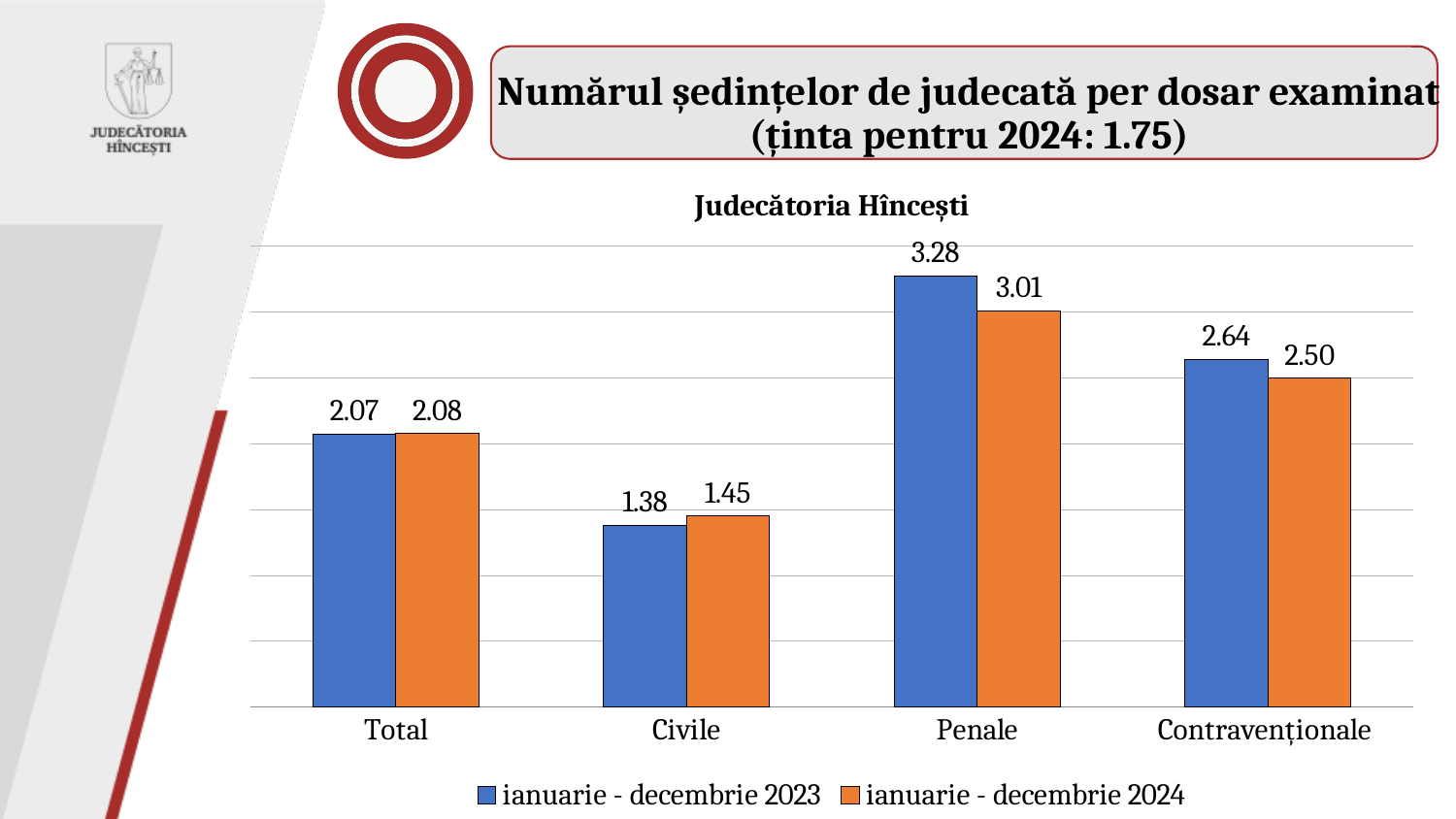
Which category has the lowest value in the ianuarie - decembrie 2023 series? Civile What is the title of the chart? Judecătoria Hîncești What is the value for Penale in the ianuarie - decembrie 2023 series? 3.28 Which category has the highest value in the ianuarie - decembrie 2024 series? Penale How many series does the legend list? 2 What kind of chart is shown on the slide? Bar chart What is the difference between the 2023 and 2024 values for Penale? 0.27 What is the value for Civile in the ianuarie - decembrie 2024 series? 1.45 What is the value for Total in the ianuarie - decembrie 2023 series? 2.07 How many categories are shown on the x axis? 4 What is the value for Contravenționale in the ianuarie - decembrie 2024 series? 2.50 Which is larger for Contravenționale: the ianuarie - decembrie 2023 value or the ianuarie - decembrie 2024 value? ianuarie - decembrie 2023